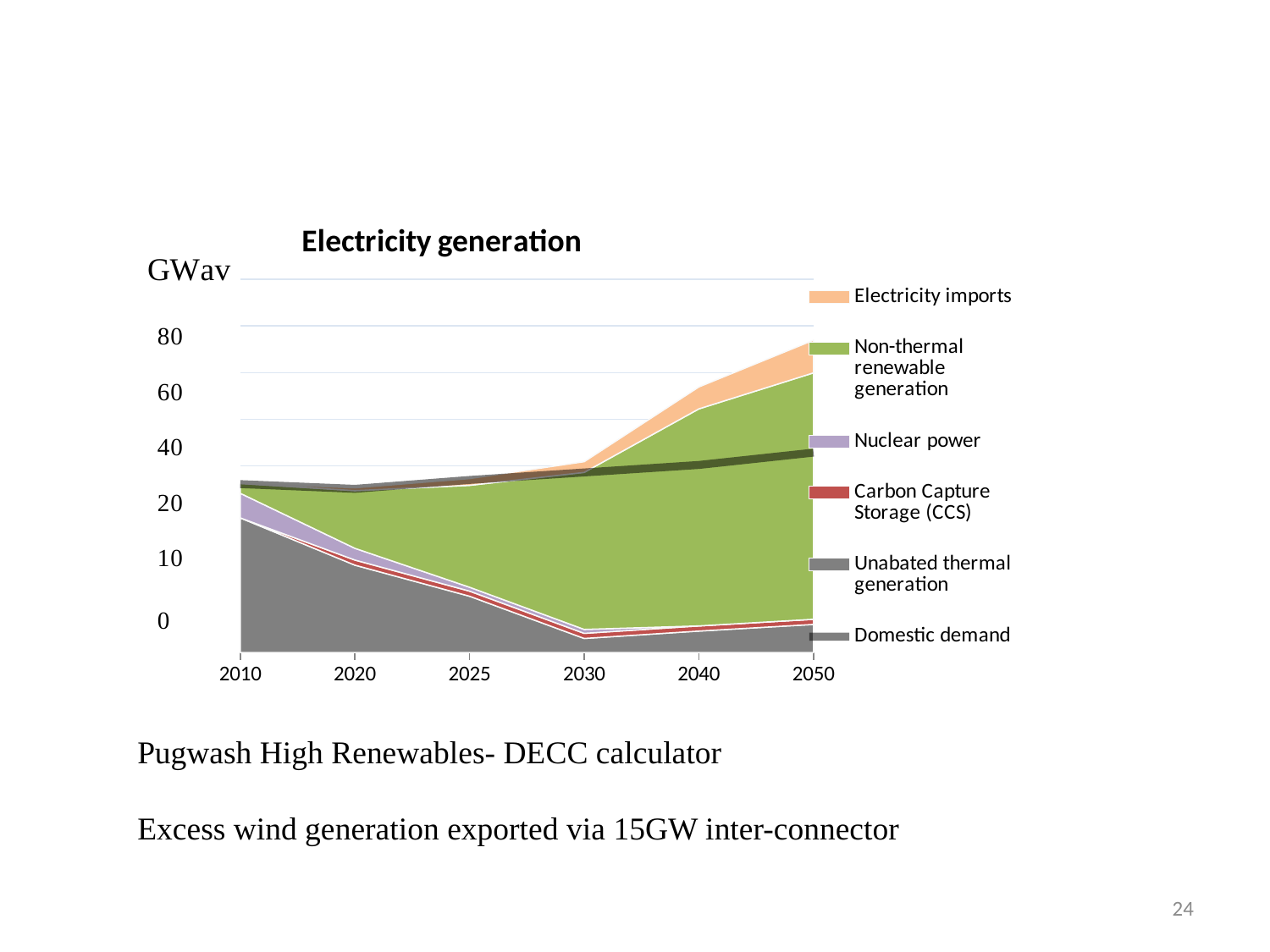
What kind of chart is shown on the slide? Stacked area chart Which series is shown in orange? Electricity imports What is the title of the chart? Electricity generation Which series makes up the largest part of the stack in 2050? Non-thermal renewable generation Does Unabated thermal generation rise or fall between 2010 and 2030? Fall How many years are labelled along the x axis? 6 Which is larger in 2050, Non-thermal renewable generation or Nuclear power? Non-thermal renewable generation What is the last year shown on the x axis? 2050 Does Non-thermal renewable generation rise or fall between 2010 and 2050? Rise What is the first year shown on the x axis? 2010 Which series makes up the largest part of the stack in 2010? Unabated thermal generation How many series does the legend list? 6